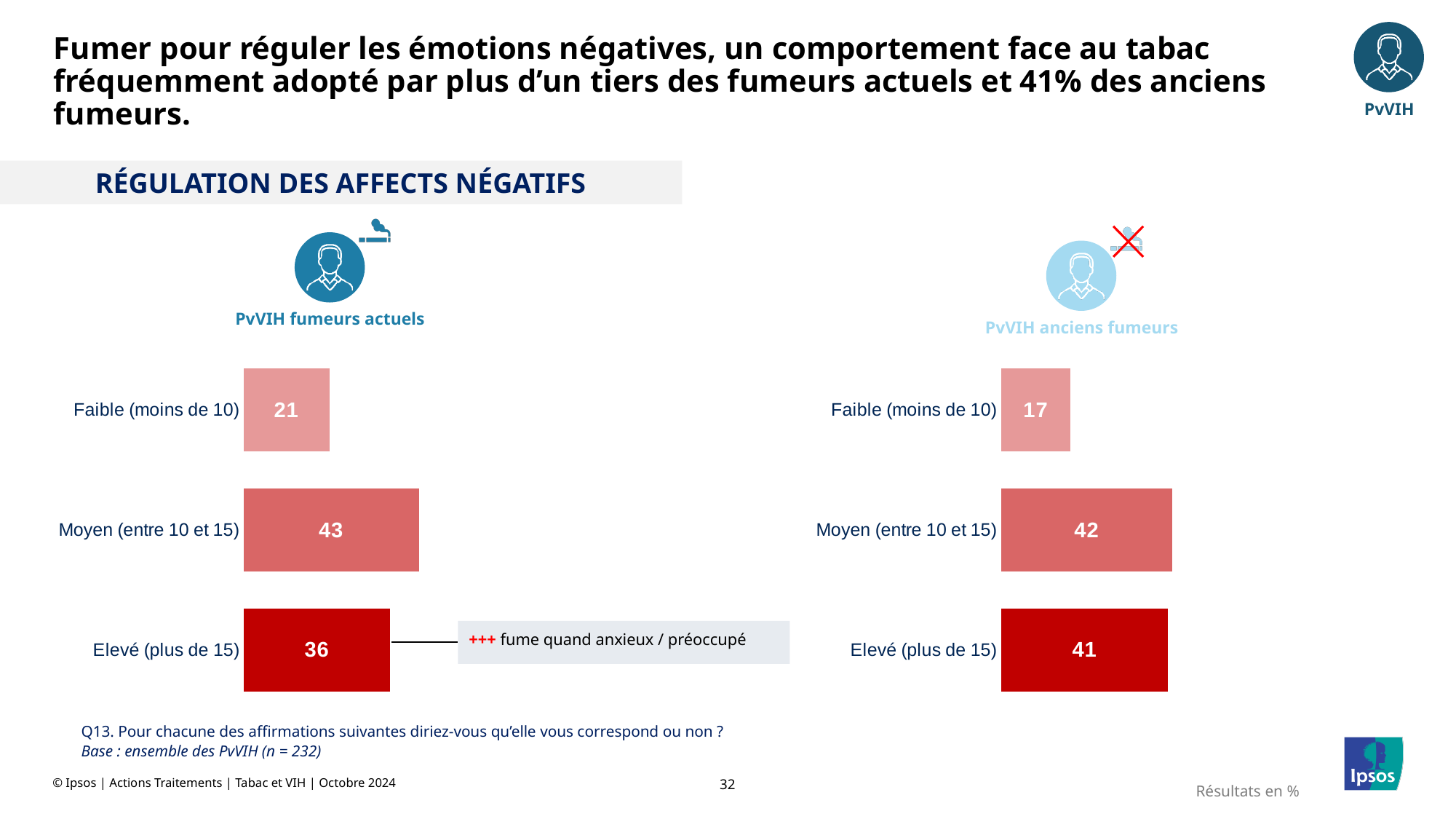
In the 'PvVIH anciens fumeurs' chart, what is the difference between 'Moyen (entre 10 et 15)' and 'Faible (moins de 10)'? 25 In the 'PvVIH fumeurs actuels' chart, which category has the lowest value? Faible (moins de 10) In the 'PvVIH fumeurs actuels' chart, what is the value for 'Faible (moins de 10)'? 21 In the 'PvVIH anciens fumeurs' chart, what is the value for 'Elevé (plus de 15)'? 41 In the 'PvVIH fumeurs actuels' chart, what is the value for 'Moyen (entre 10 et 15)'? 43 What kind of chart is the 'PvVIH fumeurs actuels' chart? Bar chart In the 'PvVIH fumeurs actuels' chart, what is the difference between 'Moyen (entre 10 et 15)' and 'Elevé (plus de 15)'? 7 In the 'PvVIH anciens fumeurs' chart, which category has the highest value? Moyen (entre 10 et 15) How many categories does the 'PvVIH anciens fumeurs' chart show? 3 In the 'PvVIH fumeurs actuels' chart, which is larger: 'Faible (moins de 10)' or 'Elevé (plus de 15)'? Elevé (plus de 15) What is the title of the section containing the two charts? RÉGULATION DES AFFECTS NÉGATIFS Which is larger: 'Elevé (plus de 15)' in the 'PvVIH fumeurs actuels' chart or 'Elevé (plus de 15)' in the 'PvVIH anciens fumeurs' chart? PvVIH anciens fumeurs